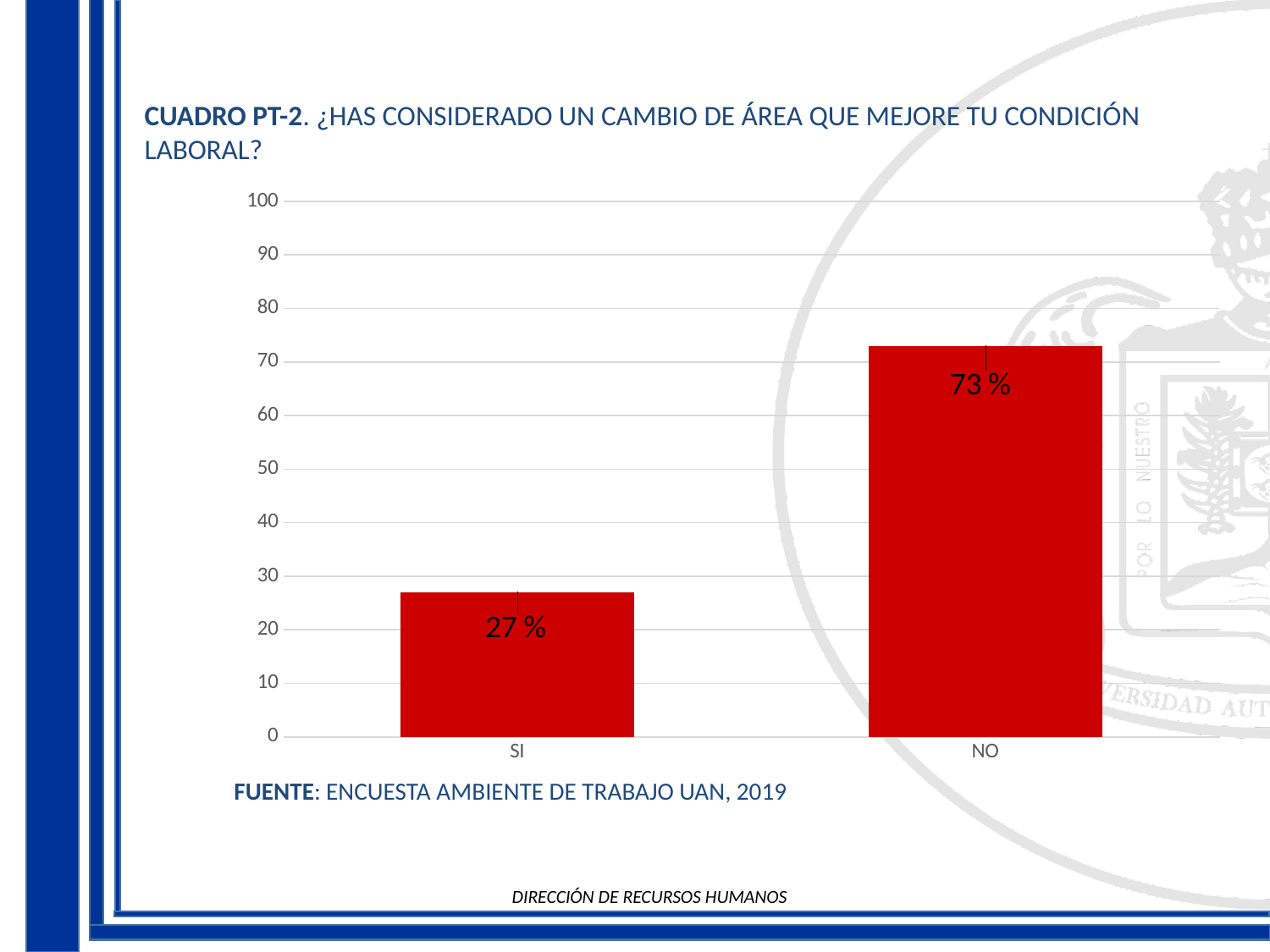
Is the value for NO greater or less than 70? greater What is the value for NO? 73 % How many categories are shown on the x axis? 2 Which category has the lowest value? SI What colour are the bars in the chart? red What is the maximum value shown on the y axis? 100 What kind of chart is shown on the slide? bar chart Is the value for SI greater or less than 30? less What is the difference between the values for NO and SI? 46 % Which is larger, the value for SI or the value for NO? NO What is the value for SI? 27 % Which category has the highest value? NO